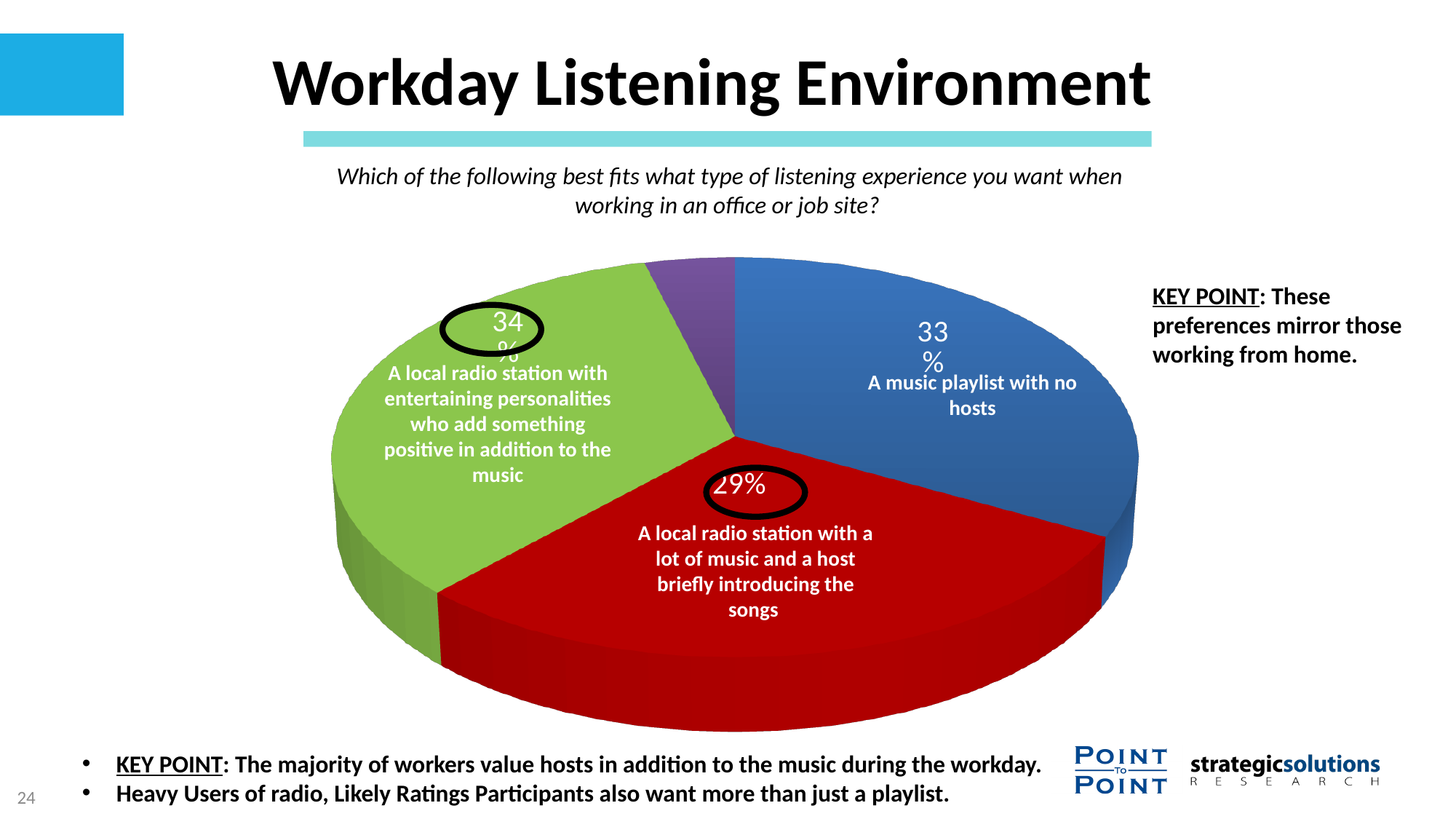
Which labeled option has the largest share of the pie? A local radio station with entertaining personalities who add something positive in addition to the music Which labeled option has the smallest share of the pie? A local radio station with a lot of music and a host briefly introducing the songs What colour is the slice for "A music playlist with no hosts"? Blue Which is larger: the share for "A music playlist with no hosts" or the share for "A local radio station with a lot of music and a host briefly introducing the songs"? A music playlist with no hosts What percentage of respondents chose "A music playlist with no hosts"? 33% What percentage chose "A local radio station with entertaining personalities who add something positive in addition to the music"? 34% What percentage chose "A local radio station with a lot of music and a host briefly introducing the songs"? 29% What type of chart is shown on the slide? Pie chart What is the difference in percentage points between "A music playlist with no hosts" and "A local radio station with a lot of music and a host briefly introducing the songs"? 4 percentage points How many slices does the pie chart have? 4 What is the difference in percentage points between the "entertaining personalities" option and the "music playlist with no hosts" option? 1 percentage point What is the title of the slide containing the pie chart? Workday Listening Environment